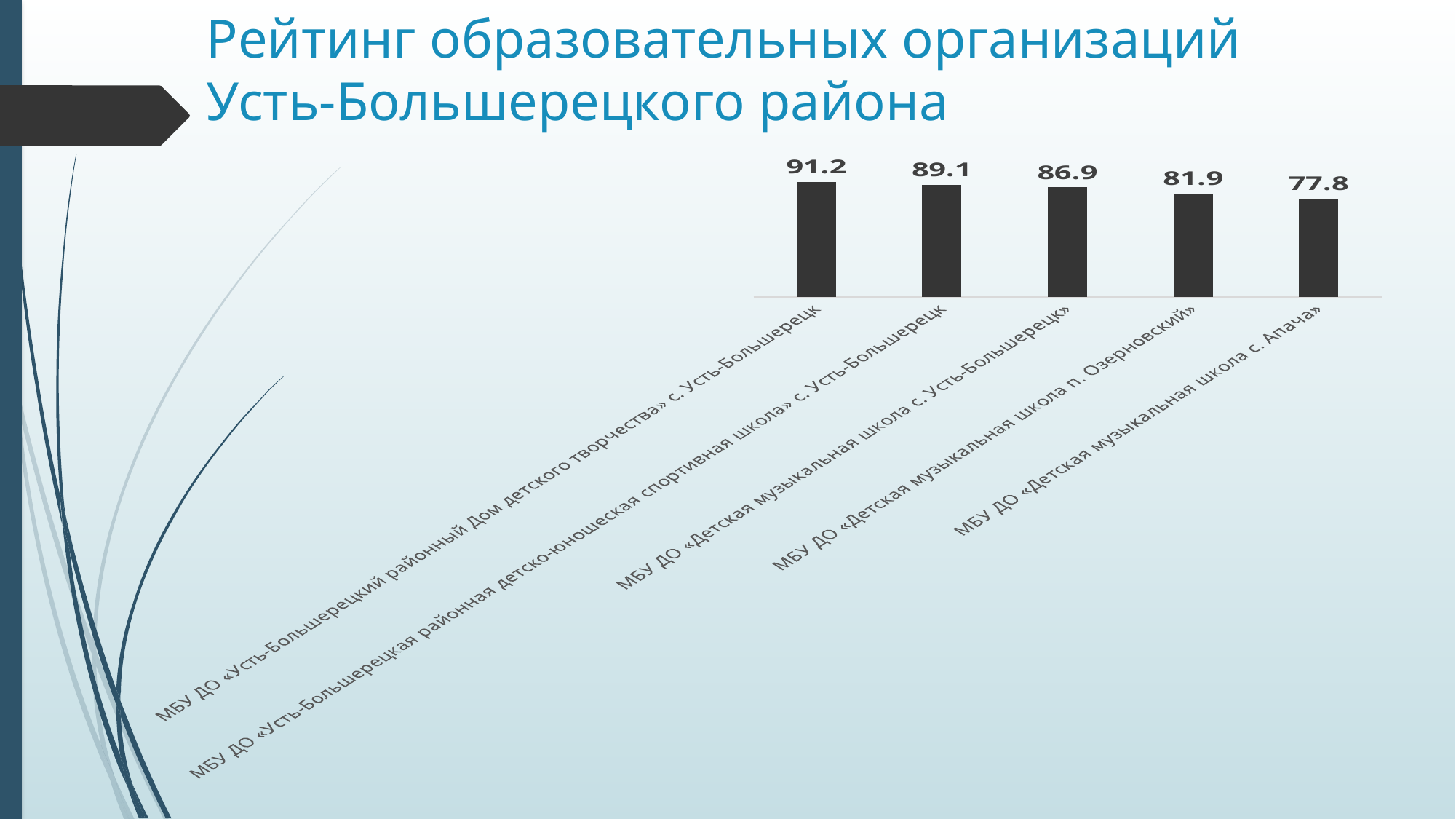
Which has a larger value: МБУ ДО «Детская музыкальная школа с. Усть-Большерецк» or МБУ ДО «Детская музыкальная школа п. Озерновский»? МБУ ДО «Детская музыкальная школа с. Усть-Большерецк» What is the value for МБУ ДО «Усть-Большерецкая районная детско-юношеская спортивная школа» с. Усть-Большерецк? 89.1 What is the difference between the values for МБУ ДО «Усть-Большерецкий районный Дом детского творчества» с. Усть-Большерецк and МБУ ДО «Детская музыкальная школа с. Апача»? 13.4 What is the value for МБУ ДО «Усть-Большерецкий районный Дом детского творчества» с. Усть-Большерецк? 91.2 Which organisation has the highest value? МБУ ДО «Усть-Большерецкий районный Дом детского творчества» с. Усть-Большерецк Do the values rise or fall from left to right across the chart? Fall What kind of chart is shown on the slide? Bar chart How many organisations are shown in the chart? 5 What is the value for МБУ ДО «Детская музыкальная школа с. Апача»? 77.8 What is the value for МБУ ДО «Детская музыкальная школа п. Озерновский»? 81.9 What is the value for МБУ ДО «Детская музыкальная школа с. Усть-Большерецк»? 86.9 Which organisation has the lowest value? МБУ ДО «Детская музыкальная школа с. Апача»